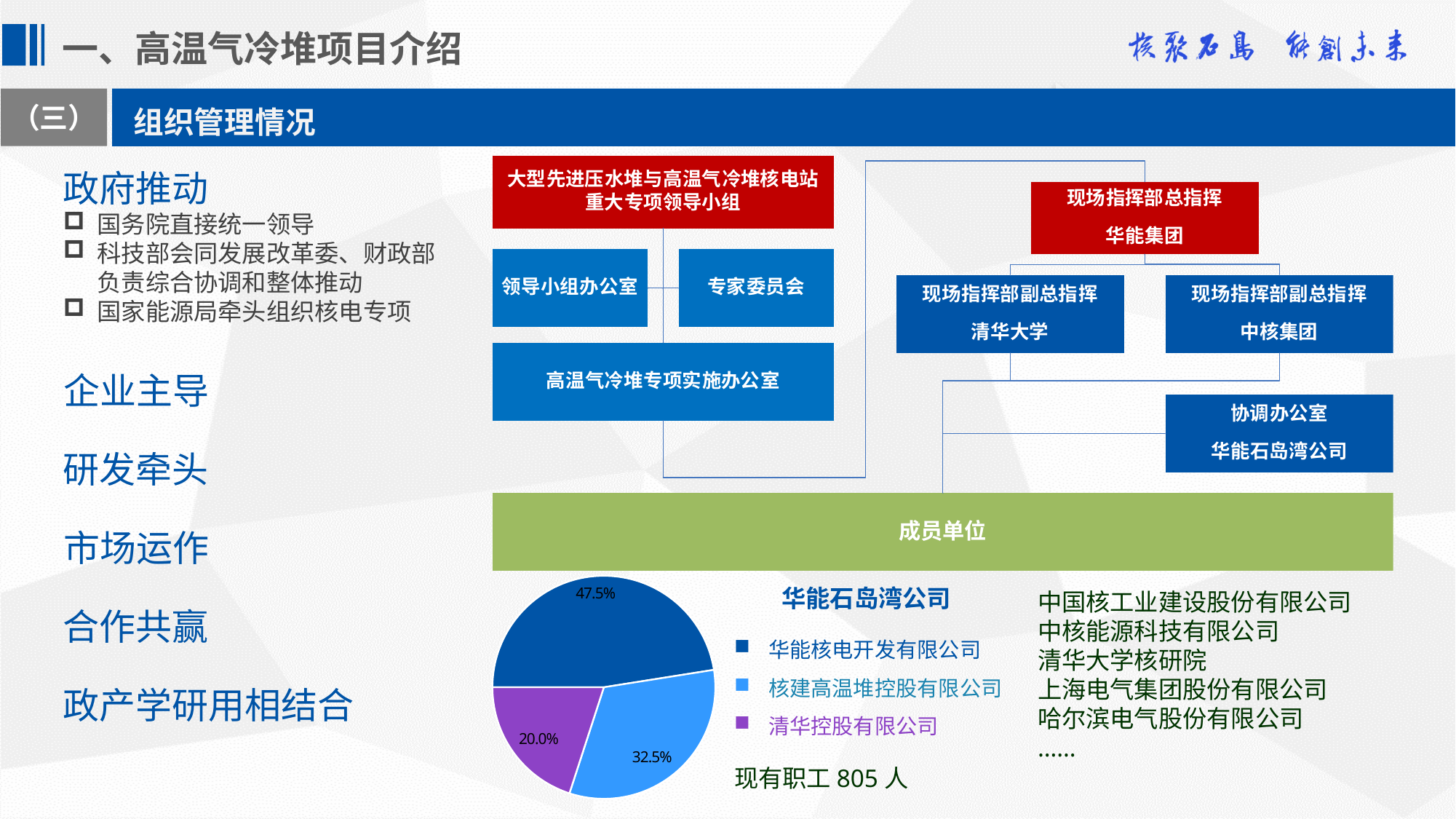
Which shareholder has the smallest slice in the pie chart? 清华控股有限公司 In the pie chart, what share does 清华控股有限公司 hold? 20.0% In the pie chart, what share does 华能核电开发有限公司 hold? 47.5% Which shareholder has the largest slice in the pie chart? 华能核电开发有限公司 How many slices does the pie chart have? 3 What is the difference between the shares of 华能核电开发有限公司 and 核建高温堆控股有限公司 in the pie chart? 15.0% What colour is the slice for 清华控股有限公司 in the pie chart? purple How many entries does the pie chart legend list? 3 In the pie chart, what share does 核建高温堆控股有限公司 hold? 32.5% What kind of chart is shown at the bottom of the slide? pie chart Which company's shareholding structure does the pie chart show? 华能石岛湾公司 Which is larger in the pie chart: the share of 核建高温堆控股有限公司 or the share of 清华控股有限公司? 核建高温堆控股有限公司